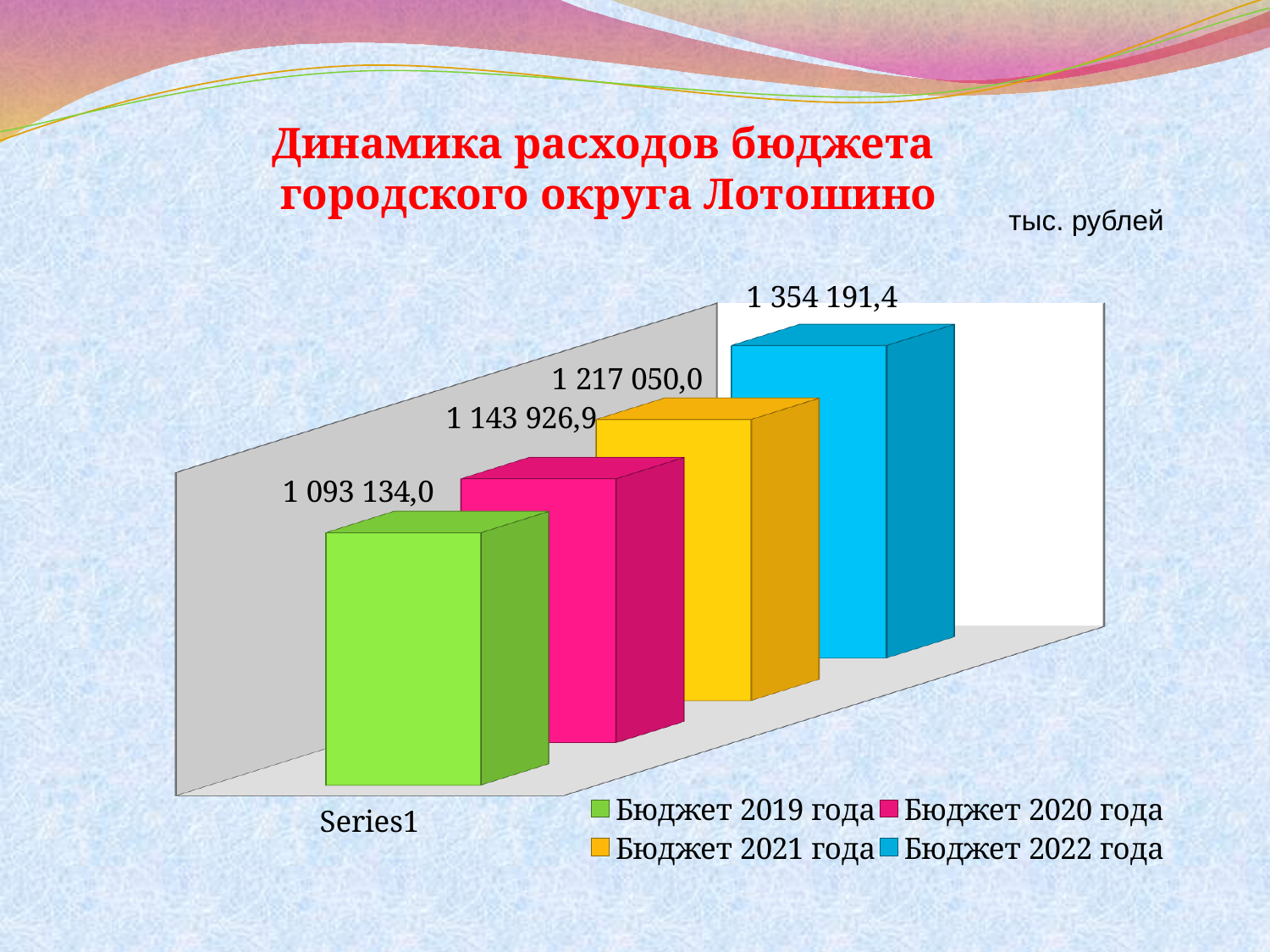
How many series does the legend list? 4 What is the value for Бюджет 2020 года? 1 143 926,9 What is the value for Бюджет 2021 года? 1 217 050,0 What is the value for Бюджет 2019 года? 1 093 134,0 Which series has the lowest value? Бюджет 2019 года Which is larger, the value for Бюджет 2020 года or Бюджет 2021 года? Бюджет 2021 года What is the difference between the values for Бюджет 2021 года and Бюджет 2020 года? 73 123,1 What is the value for Бюджет 2022 года? 1 354 191,4 What unit is indicated for the values on the chart? тыс. рублей Which series has the highest value? Бюджет 2022 года What is the difference between the values for Бюджет 2022 года and Бюджет 2019 года? 261 057,4 What kind of chart is shown on the slide? Bar chart